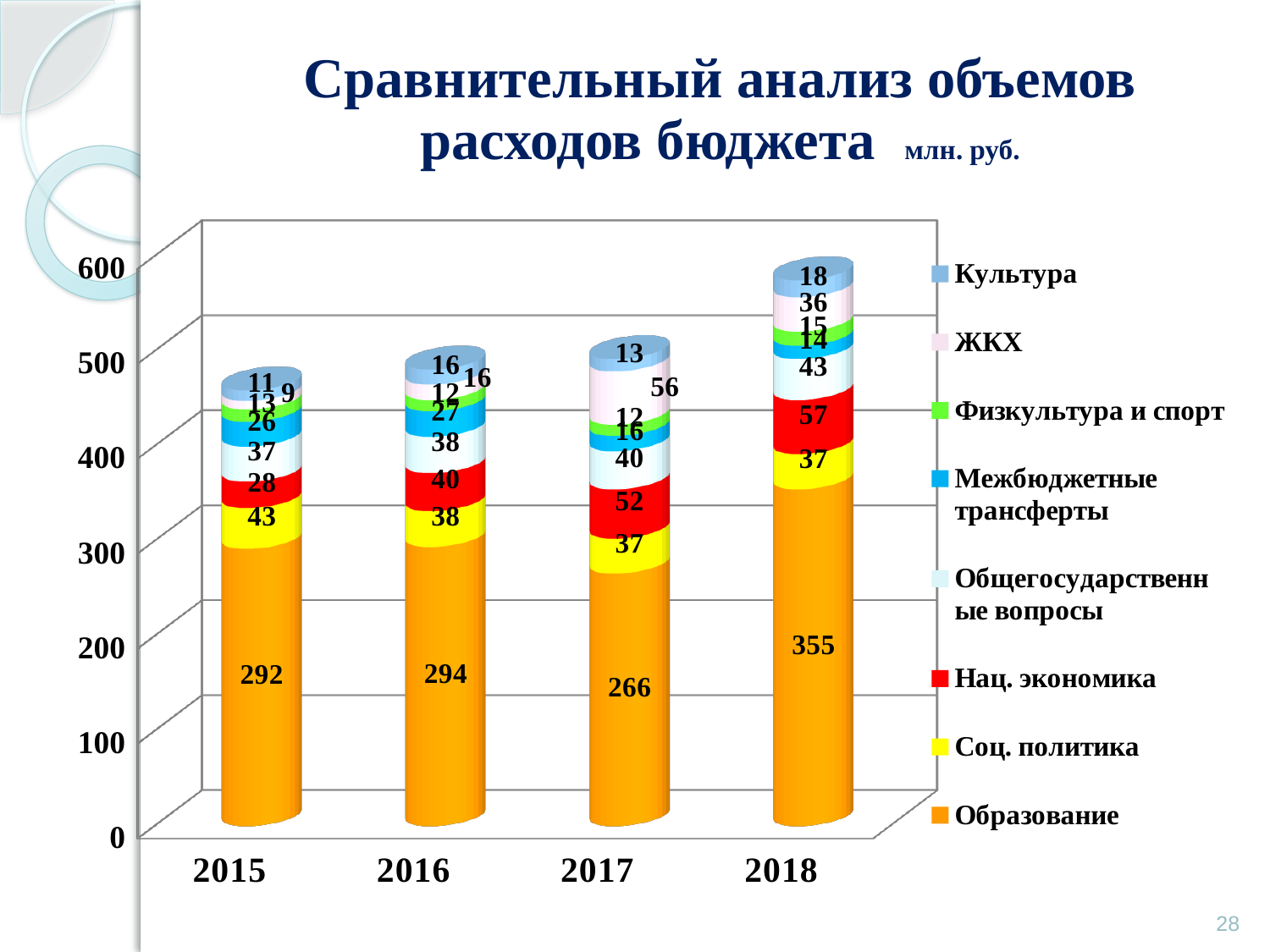
In which year is the value for Образование the highest? 2018 What is the value for Образование in 2018? 355 Which year has the larger value for Соц. политика, 2015 or 2016? 2015 Is the total height of the 2018 stacked bar greater or less than 500? greater How many series does the legend list? 8 In which year is the value for Образование the lowest? 2017 What kind of chart is shown on the slide? bar chart What is the difference between the Образование values for 2018 and 2017? 89 How many years are shown on the x axis of the chart? 4 What unit of measurement is stated in the chart title? млн. руб. What is the value for Нац. экономика in 2017? 52 What is the value for ЖКХ in 2017? 56